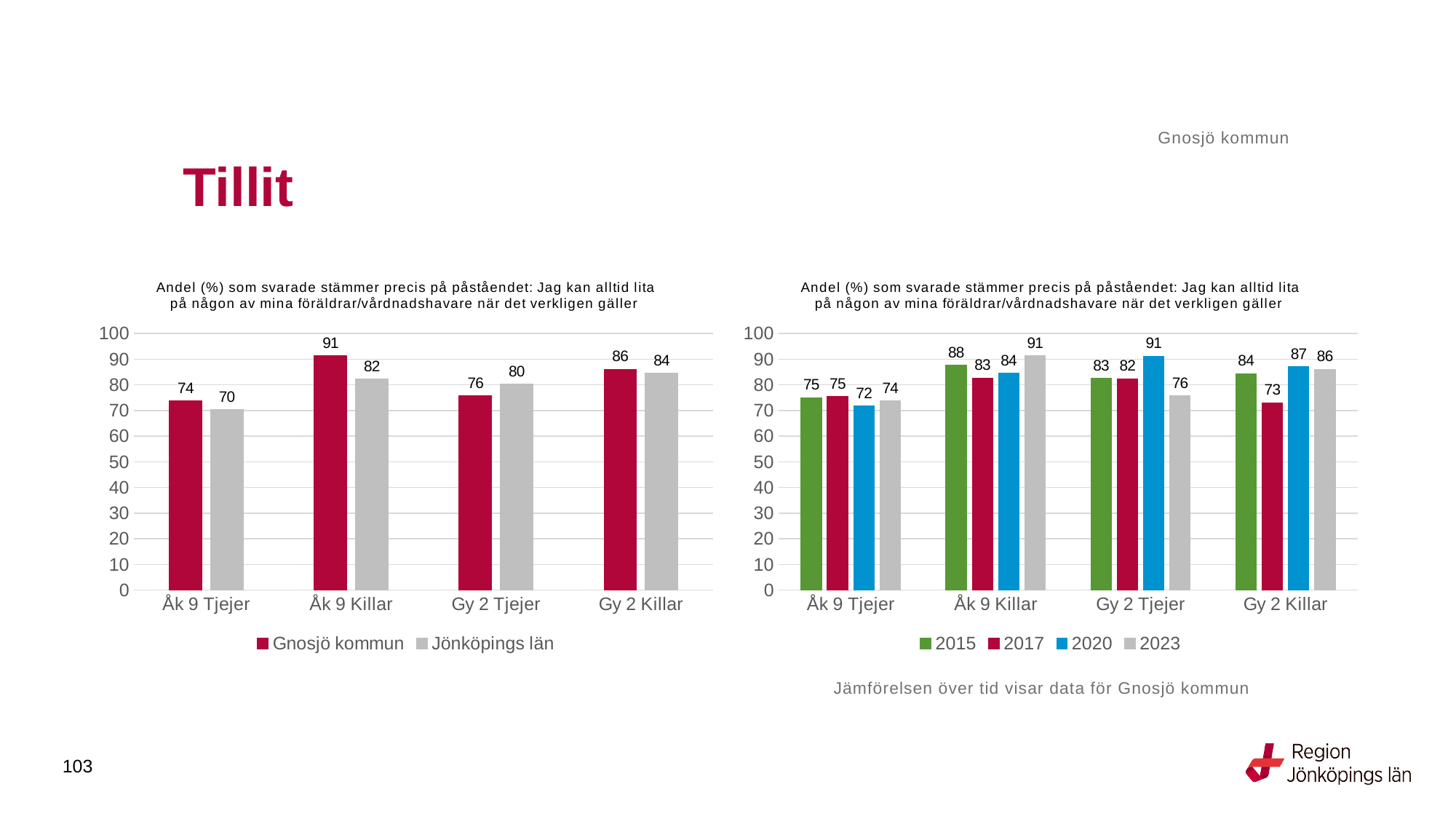
In the left chart, what is the difference between Gnosjö kommun and Jönköpings län for Åk 9 Killar? 9 In the right chart, what is the value for 2017 for Gy 2 Killar? 73 In the right chart, how many series does the legend list? 4 In the left chart, which category has the lowest value for Jönköpings län? Åk 9 Tjejer In the right chart, which is larger for Åk 9 Tjejer: the 2020 value or the 2023 value? 2023 What type of chart is the left chart? Bar chart In the left chart, how many series does the legend list? 2 In the right chart, which category has the highest value for 2023? Åk 9 Killar In the left chart, what is the value for Gnosjö kommun for Åk 9 Killar? 91 In the right chart, what is the value for 2020 for Gy 2 Tjejer? 91 In the right chart, what is the difference between the 2020 and 2023 values for Gy 2 Tjejer? 15 In the left chart, what is the value for Jönköpings län for Gy 2 Tjejer? 80